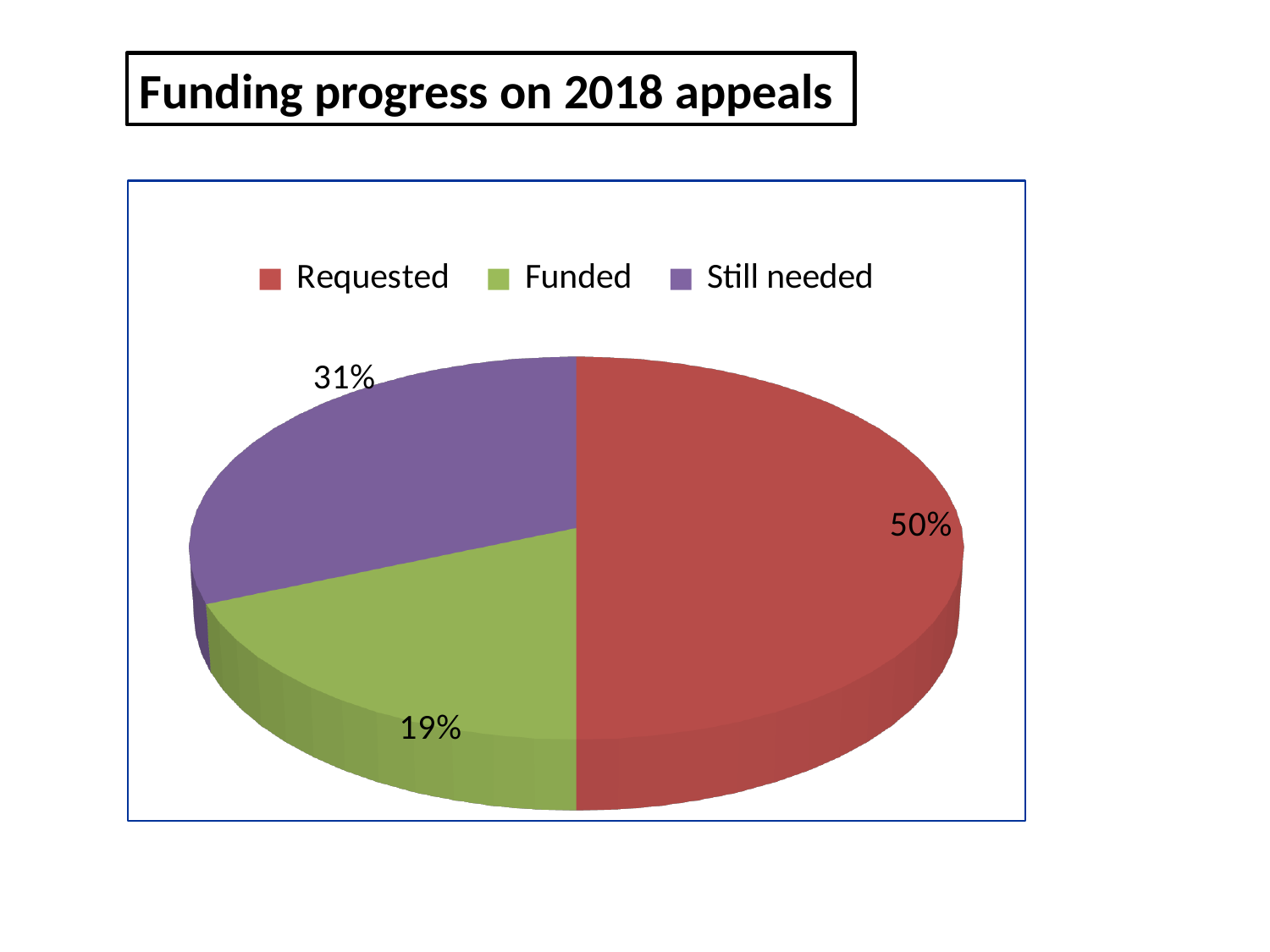
What is the difference in percentage points between the Still needed and Funded slices? 12 What share of the pie does the Requested slice represent? 50% What kind of chart is shown on the slide? Pie chart Which category has the largest slice of the pie? Requested What is the title of the slide? Funding progress on 2018 appeals How many slices does the pie chart have? 3 What is the difference in percentage points between the Requested and Funded slices? 31 Which is larger, the Still needed slice or the Funded slice? Still needed What colour is the Funded slice in the pie chart? Green What share of the pie does the Still needed slice represent? 31% Which category has the smallest slice of the pie? Funded What share of the pie does the Funded slice represent? 19%